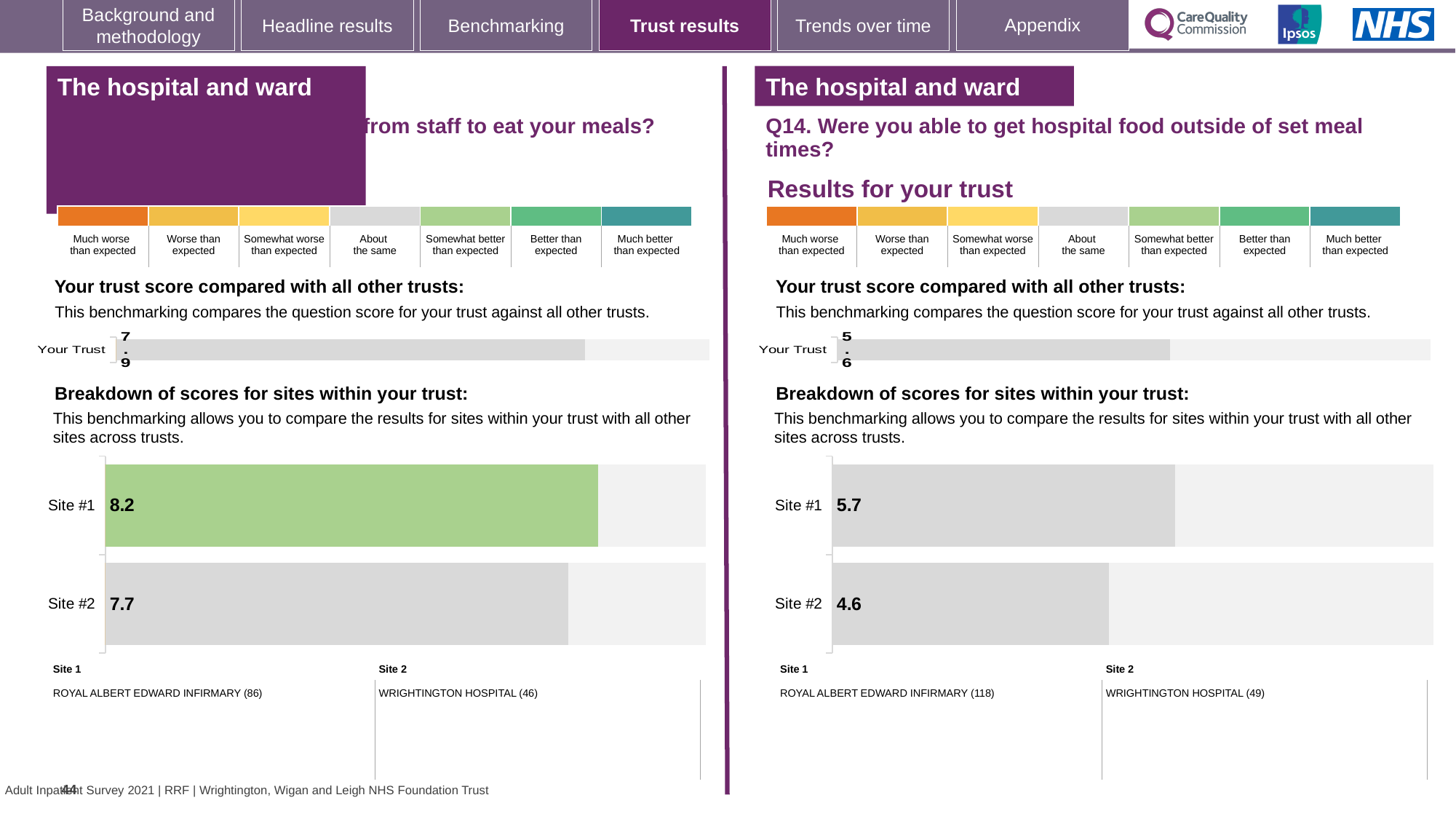
On the right-hand chart (Q14, hospital food outside of set meal times), what is the score for Site #1? 5.7 On the right-hand chart (Q14), which site has the higher score? Site #1 On the right-hand side (Q14), what is the 'Your Trust' score shown in the trust comparison bar? 5.6 On the left-hand chart, what is the difference between the Site #1 and Site #2 scores? 0.5 On the left-hand chart, which site has the lower score? Site #2 On the left-hand chart (breakdown of scores for sites), what is the score for Site #1? 8.2 On the right-hand chart (Q14), what is the difference between the Site #1 and Site #2 scores? 1.1 On the right-hand chart (Q14), what is the score for Site #2? 4.6 How many sites are shown in the right-hand site breakdown chart (Q14)? 2 On the left-hand side, what is the 'Your Trust' score shown in the trust comparison bar? 7.9 What type of chart is used for the breakdown of scores for sites on the right-hand side (Q14)? Bar chart On the left-hand chart (breakdown of scores for sites), what is the score for Site #2? 7.7